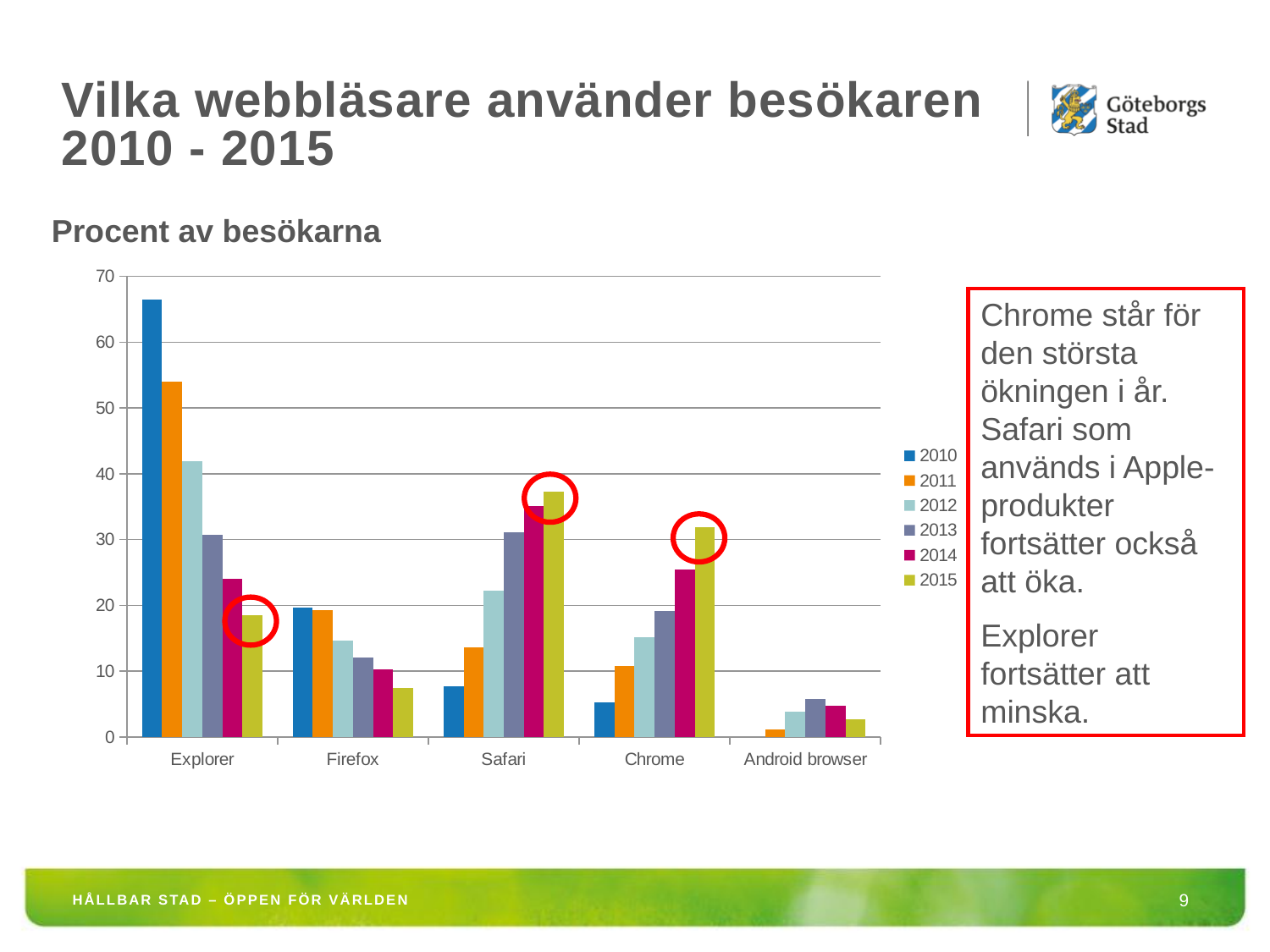
Is the value for Safari in 2015 greater or less than 30? greater Which browser has the lowest value in 2015? Android browser Which is larger in 2015, the value for Safari or the value for Chrome? Safari What kind of chart is shown on the slide? bar chart Do the values for Safari rise or fall from 2010 to 2015? rise What is the label shown above the chart describing the measured quantity? Procent av besökarna How many series does the legend list? 6 How many browser categories are shown on the x axis? 5 Do the values for Explorer rise or fall from 2010 to 2015? fall Is the value for Explorer in 2015 greater or less than 20? less Is the value for Explorer in 2010 greater or less than 60? greater Which browser and year has the tallest bar in the chart? Explorer, 2010